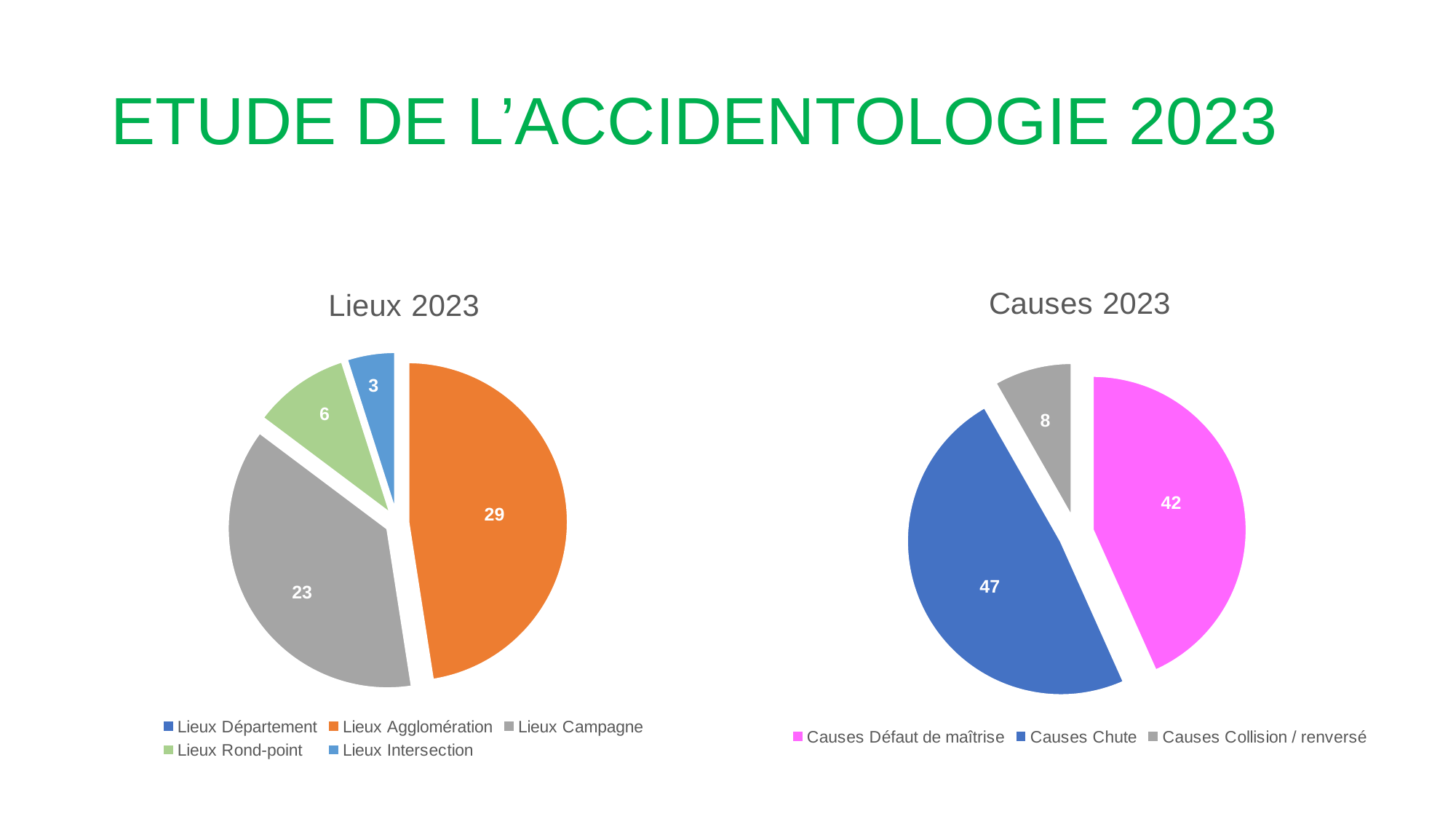
In the Causes 2023 chart, what is the value for Causes Défaut de maîtrise? 42 In the Causes 2023 chart, what is the value for Causes Chute? 47 What kind of chart is the Causes 2023 chart? Pie chart In the Causes 2023 chart, what is the value for Causes Collision / renversé? 8 In the Lieux 2023 chart, what is the value for Lieux Intersection? 3 In the Lieux 2023 chart, what is the value for Lieux Agglomération? 29 In the Lieux 2023 chart, what is the value for Lieux Rond-point? 6 In the Lieux 2023 chart, what is the difference between Lieux Agglomération and Lieux Campagne? 6 In the Causes 2023 chart, which is larger, Causes Chute or Causes Défaut de maîtrise? Causes Chute In the Causes 2023 chart, which category has the smallest slice? Causes Collision / renversé In the Lieux 2023 chart, what is the value for Lieux Campagne? 23 In the Lieux 2023 chart, which category has the largest slice? Lieux Agglomération